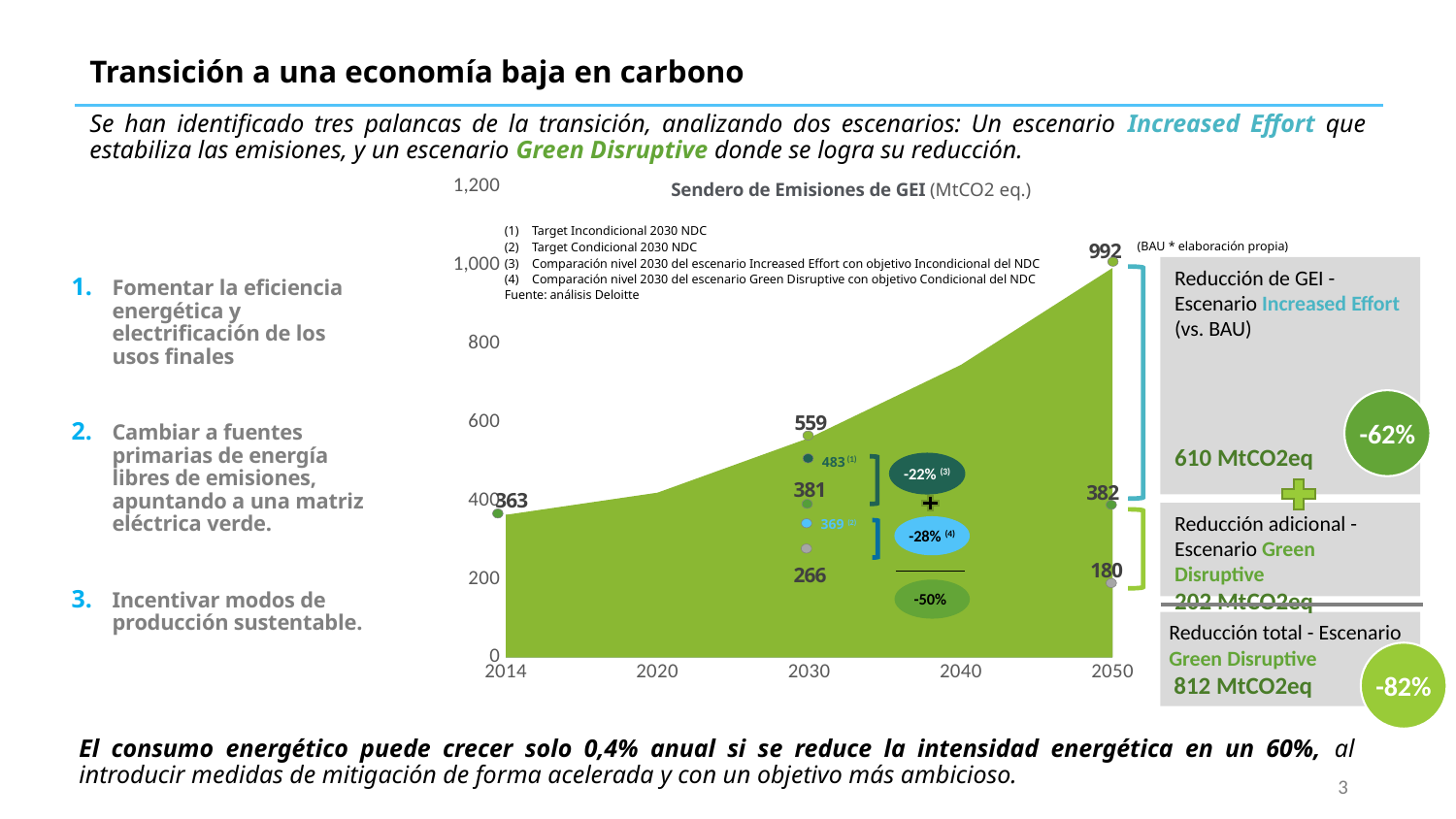
What is the emissions value labeled for 2014? 363 Does the BAU emissions area rise or fall from 2014 to 2050? Rises What is the highest emissions value labeled for 2030? 559 What is the value of the Target Incondicional 2030 NDC (1) shown on the chart? 483 What is the BAU emissions value labeled for 2050? 992 What is the difference between the 2030 BAU value (559) and the 2014 value (363)? 196 How many year labels are shown on the x axis? 5 What percentage reduction of GEI is shown for the Increased Effort scenario vs. BAU? -62% What is the difference between the BAU value in 2050 (992) and the value 382 in 2050? 610 What is the lowest value labeled on the chart for 2050? 180 What is the title of the chart? Sendero de Emisiones de GEI (MtCO2 eq.) What kind of chart is shown on the slide? Area chart